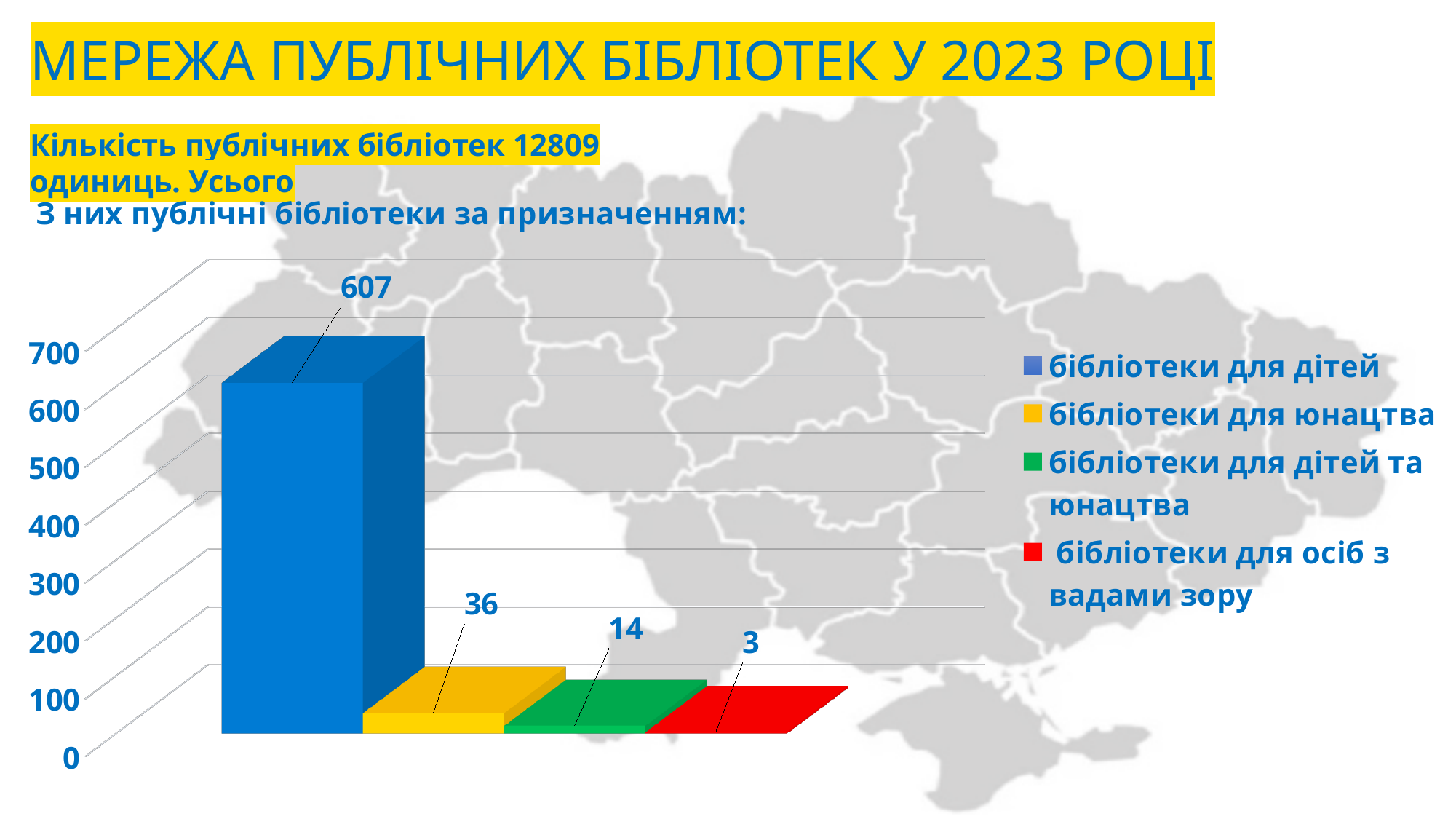
Which category has the lowest value? бібліотеки для осіб з вадами зору What is the value for бібліотеки для дітей та юнацтва? 14 How many entries does the legend list? 4 What is the difference between the values for бібліотеки для дітей and бібліотеки для юнацтва? 571 Which is larger, the value for бібліотеки для юнацтва or for бібліотеки для дітей та юнацтва? бібліотеки для юнацтва How many bars are plotted in the chart? 4 What is the value for бібліотеки для осіб з вадами зору? 3 Is the value for бібліотеки для дітей greater or less than 500? greater Which category has the highest value? бібліотеки для дітей What is the value for бібліотеки для дітей? 607 What kind of chart is shown on the slide? bar chart What is the value for бібліотеки для юнацтва? 36